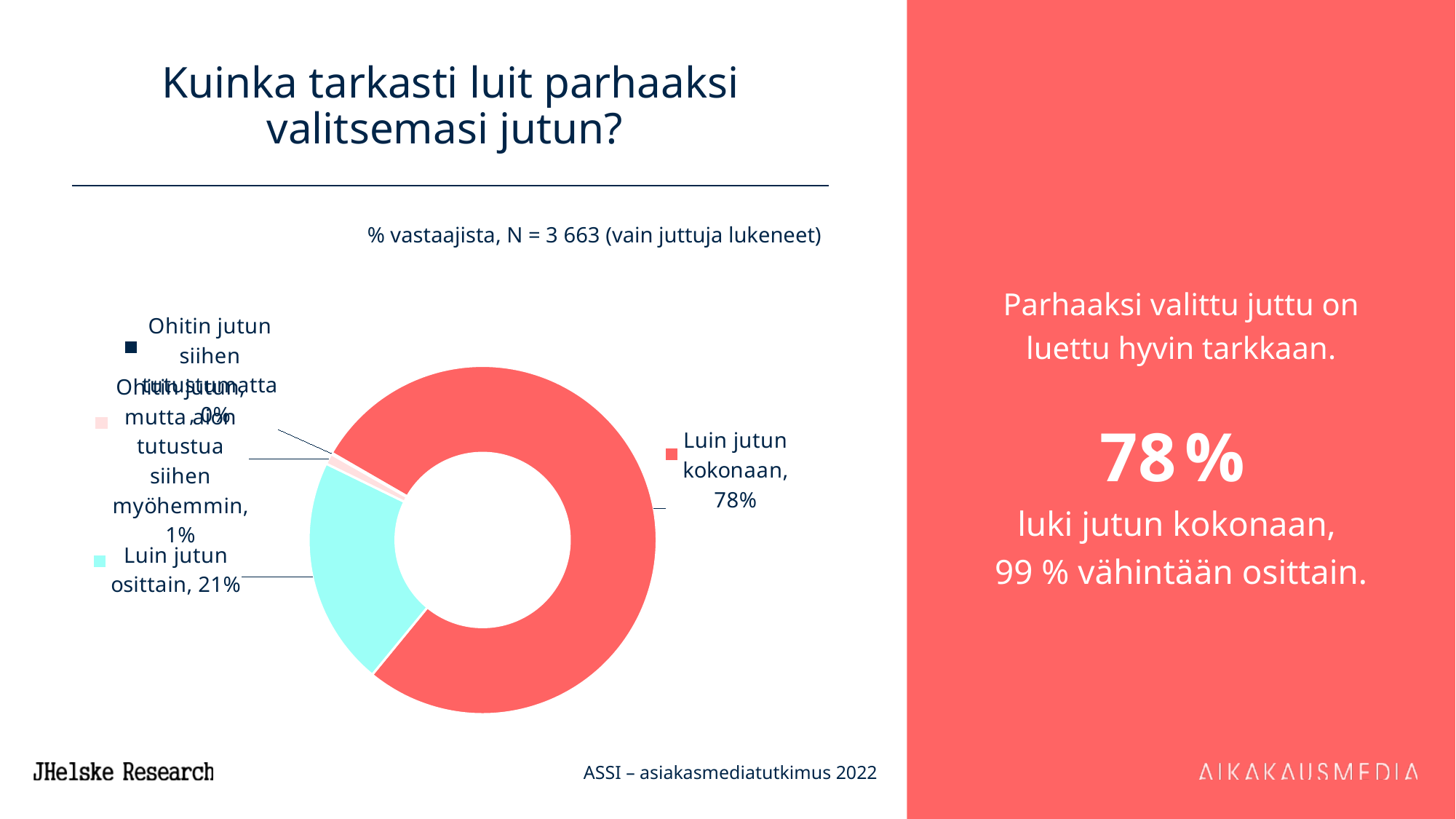
What kind of chart is shown on the slide? Donut (pie) chart How many categories does the chart show? 4 Which is larger: the share for "Luin jutun osittain" or for "Ohitin jutun, mutta aion tutustua siihen myöhemmin"? Luin jutun osittain What percentage of respondents chose "Luin jutun kokonaan"? 78% What percentage of respondents chose "Ohitin jutun siihen tutustumatta"? 0% Which category has the largest share of the chart? Luin jutun kokonaan What percentage of respondents chose "Ohitin jutun, mutta aion tutustua siihen myöhemmin"? 1% What is the difference in percentage points between "Luin jutun kokonaan" and "Luin jutun osittain"? 57 What percentage of respondents chose "Luin jutun osittain"? 21% What colour is the "Luin jutun osittain" slice? Light blue (cyan) What is the sample size (N) stated above the chart? 3 663 Which category has the smallest share of the chart? Ohitin jutun siihen tutustumatta